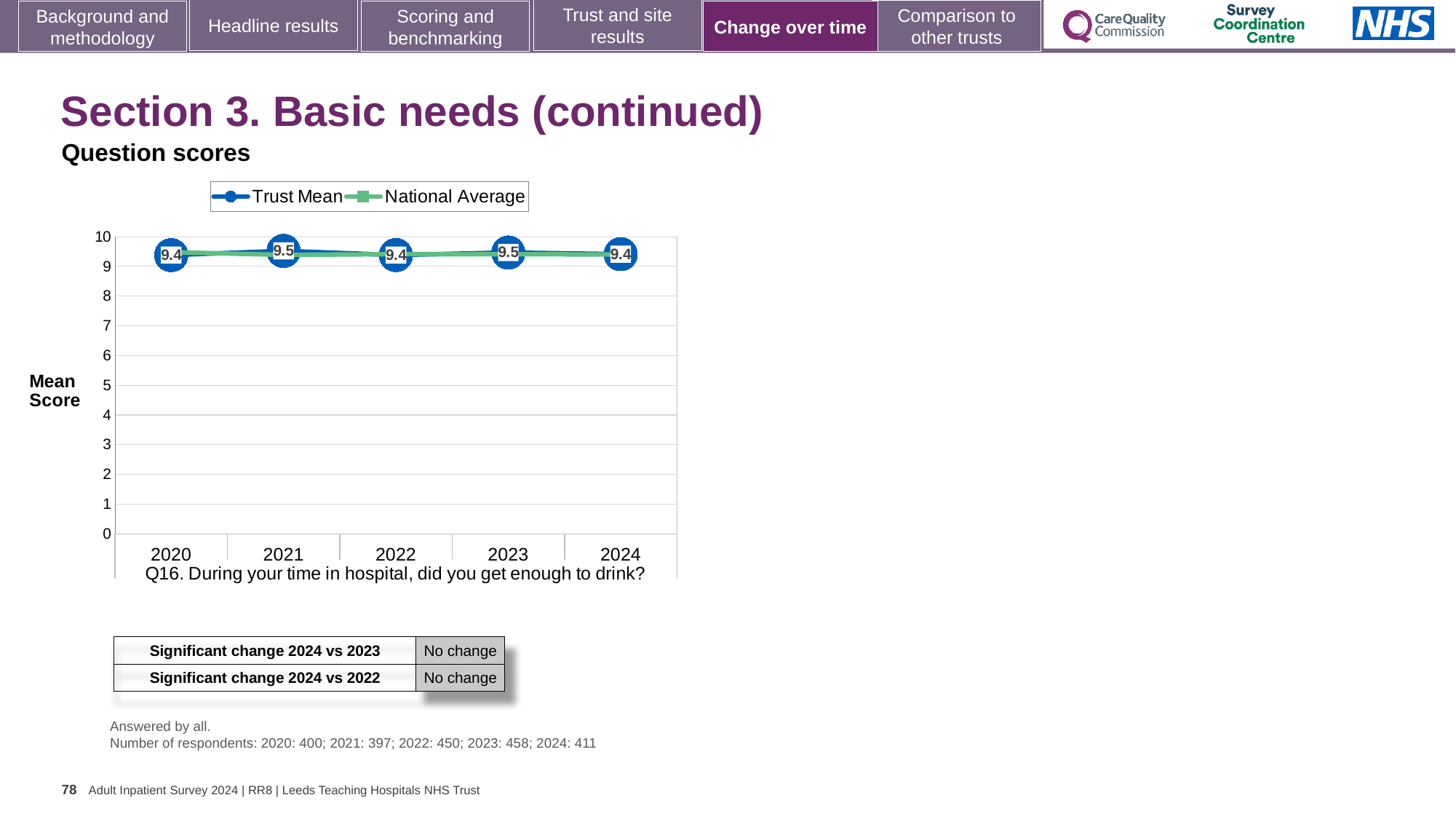
What is the difference between the Trust Mean scores for 2021 and 2020? 0.1 Which two series are listed in the chart legend? Trust Mean and National Average What is the Trust Mean score for 2020? 9.4 What is the Trust Mean score for 2024? 9.4 What survey question is the chart about, as shown below the x axis? Q16. During your time in hospital, did you get enough to drink? Which year has the larger Trust Mean score, 2022 or 2023? 2023 What is the Trust Mean score for 2021? 9.5 What kind of chart is shown on the slide? Line chart How many series does the chart legend list? 2 Is the National Average value for 2024 greater or less than 8? greater What is the Trust Mean score for 2023? 9.5 How many years are plotted on the x axis of the chart? 5